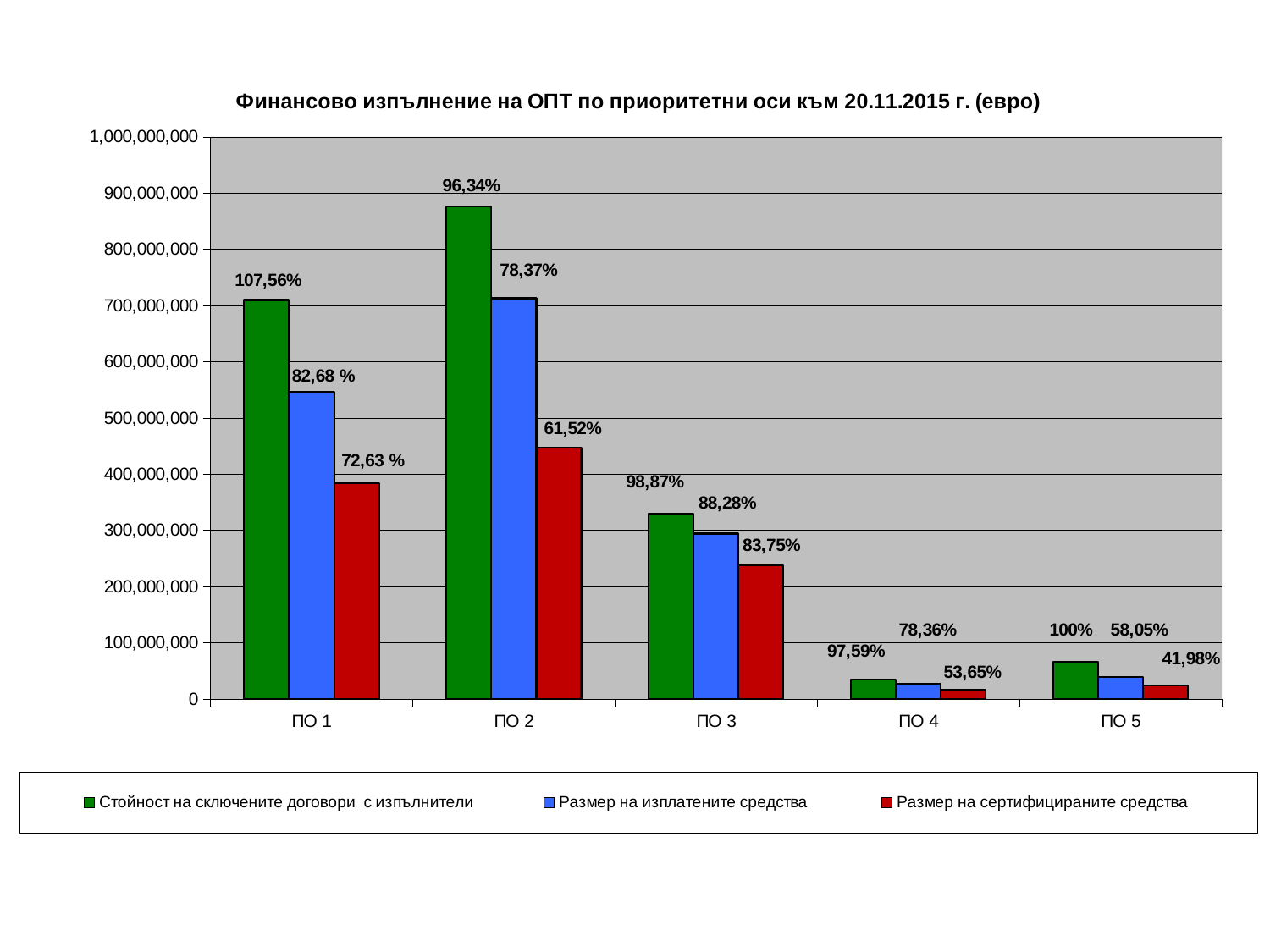
Which is larger: the blue bar (Размер на изплатените средства) for ПО 1 or for ПО 2? ПО 2 How many series does the legend list? 3 Which category has the lowest green bar (Стойност на сключените договори с изпълнители)? ПО 4 How many priority axis categories are shown on the x axis? 5 What percentage label is printed above the blue bar (Размер на изплатените средства) for ПО 5? 58,05% What percentage label is printed above the red bar (Размер на сертифицираните средства) for ПО 1? 72,63 % Which category has the highest green bar (Стойност на сключените договори с изпълнители)? ПО 2 What kind of chart is shown on the slide? Bar chart Is the green bar (Стойност на сключените договори с изпълнители) for ПО 2 greater or less than 800,000,000? greater What percentage label is printed above the green bar (Стойност на сключените договори с изпълнители) for ПО 2? 96,34% Is the red bar (Размер на сертифицираните средства) for ПО 2 greater or less than 500,000,000? less What colour represents Размер на сертифицираните средства in the legend? Red